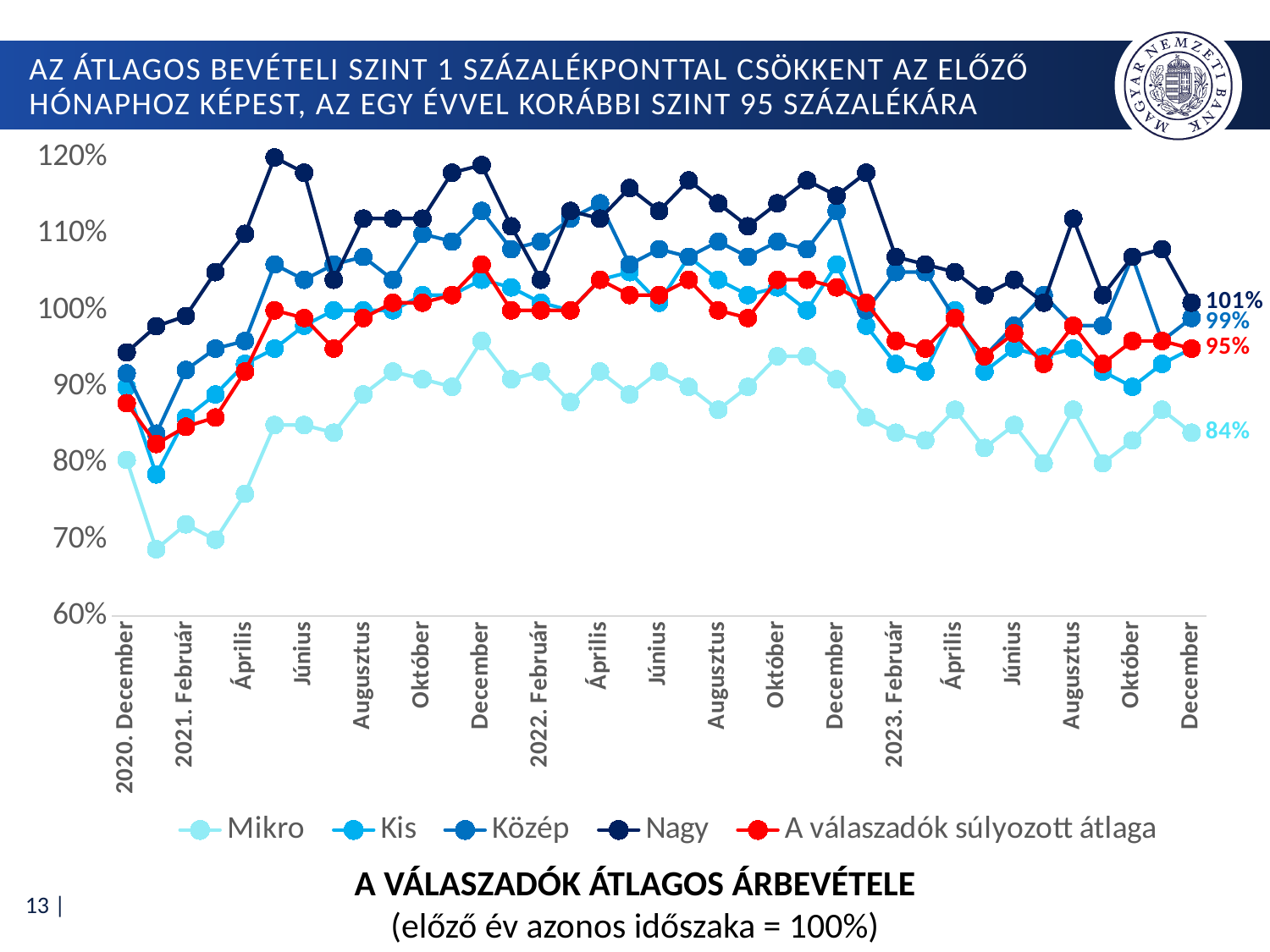
How many series does the legend list? 5 What is the value of the Mikro series at 2023 December? 84% Which series is drawn in red? A válaszadók súlyozott átlaga What is the value of the Nagy series at 2023 December? 101% Is the value for Nagy at 2021 Június greater or less than 110%? greater Which series has the highest value at 2023 December? Nagy What is the difference between the Nagy value (101%) and the Mikro value (84%) at 2023 December? 17 percentage points Which series has the lowest value at 2023 December? Mikro What is the value of 'A válaszadók súlyozott átlaga' at 2023 December? 95% What is the title of the chart? A VÁLASZADÓK ÁTLAGOS ÁRBEVÉTELE What kind of chart is shown on the slide? line chart Is the value for Mikro at 2021 Április greater or less than 80%? less